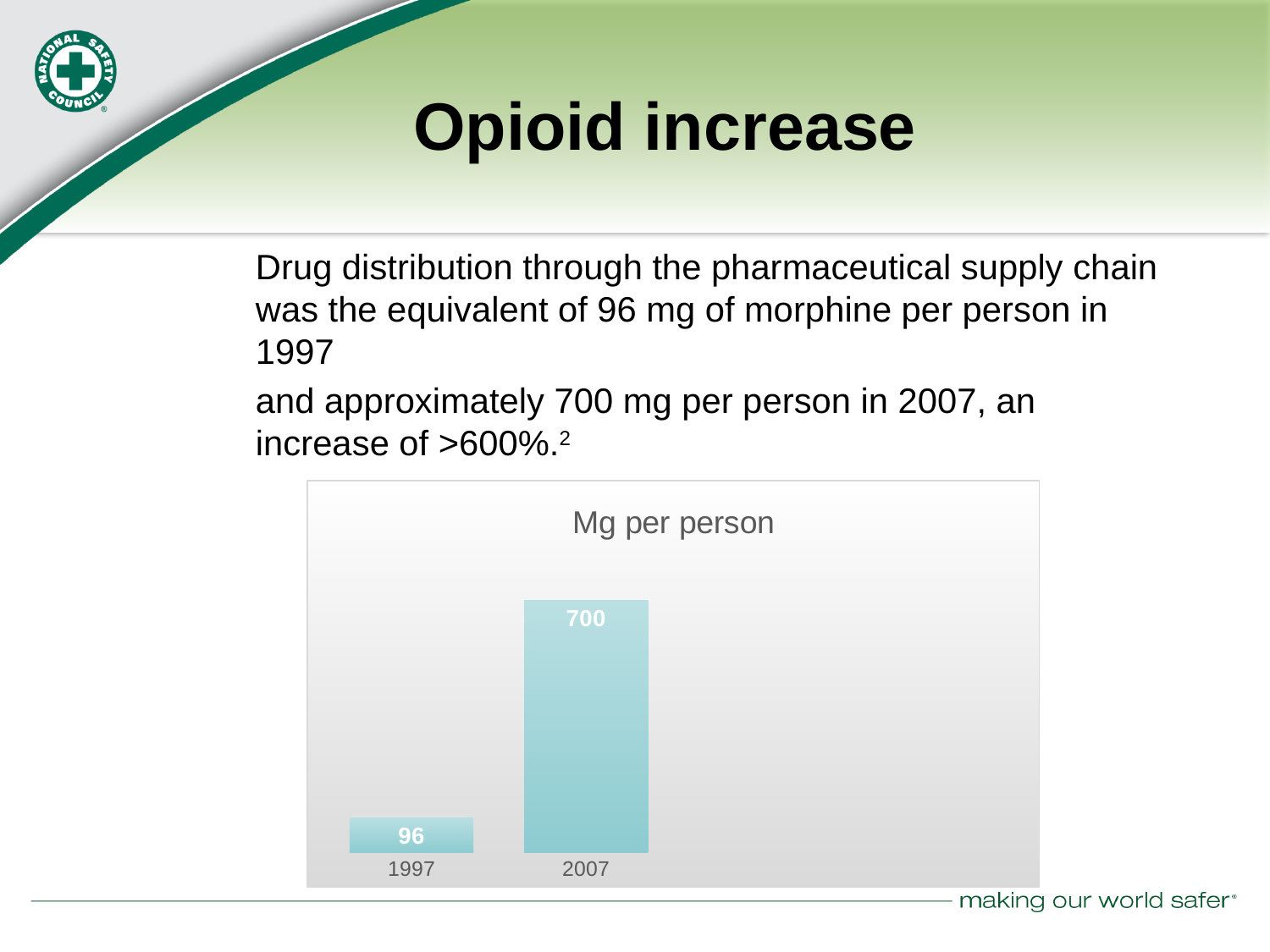
Do the values rise or fall from 1997 to 2007 in the chart? rise Which year has the higher value in the Mg per person chart? 2007 Is the value for 2007 larger or smaller than the value for 1997? larger How many bars are shown in the Mg per person chart? 2 What is the total of the two values shown in the Mg per person chart? 796 What kind of chart is shown on the slide? bar chart What is the title of the chart on the slide? Mg per person What is the value for 1997 in the Mg per person chart? 96 What is the value for 2007 in the Mg per person chart? 700 What is the difference between the 2007 and 1997 values in the Mg per person chart? 604 Which year has the lower value in the Mg per person chart? 1997